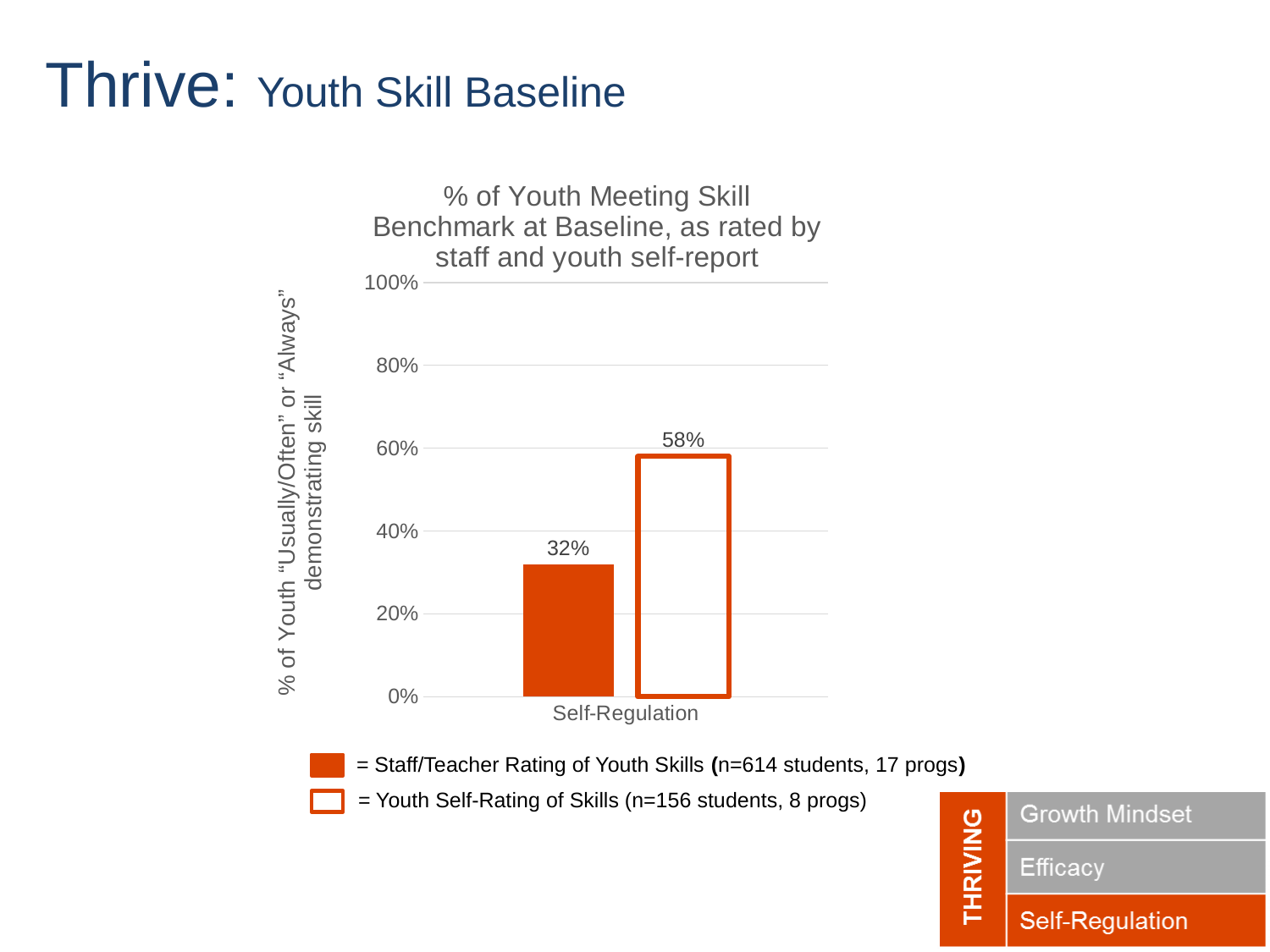
What is the difference between the Youth Self-Rating and the Staff/Teacher Rating for Self-Regulation? 26% How many students are in the Staff/Teacher Rating of Youth Skills sample according to the legend? 614 Is the Staff/Teacher Rating for Self-Regulation greater or less than 40%? less Which rating is higher for Self-Regulation, the Staff/Teacher Rating or the Youth Self-Rating? Youth Self-Rating of Skills What is the Staff/Teacher Rating of Youth Skills value for Self-Regulation? 32% Is the Youth Self-Rating for Self-Regulation greater or less than 40%? greater How many series does the legend list? 2 What is the title of the chart? % of Youth Meeting Skill Benchmark at Baseline, as rated by staff and youth self-report What is the Youth Self-Rating of Skills value for Self-Regulation? 58% What is the highest value shown on the y axis of the chart? 100% What kind of chart is shown on the slide? Bar chart How many categories are shown on the x axis of the chart? 1